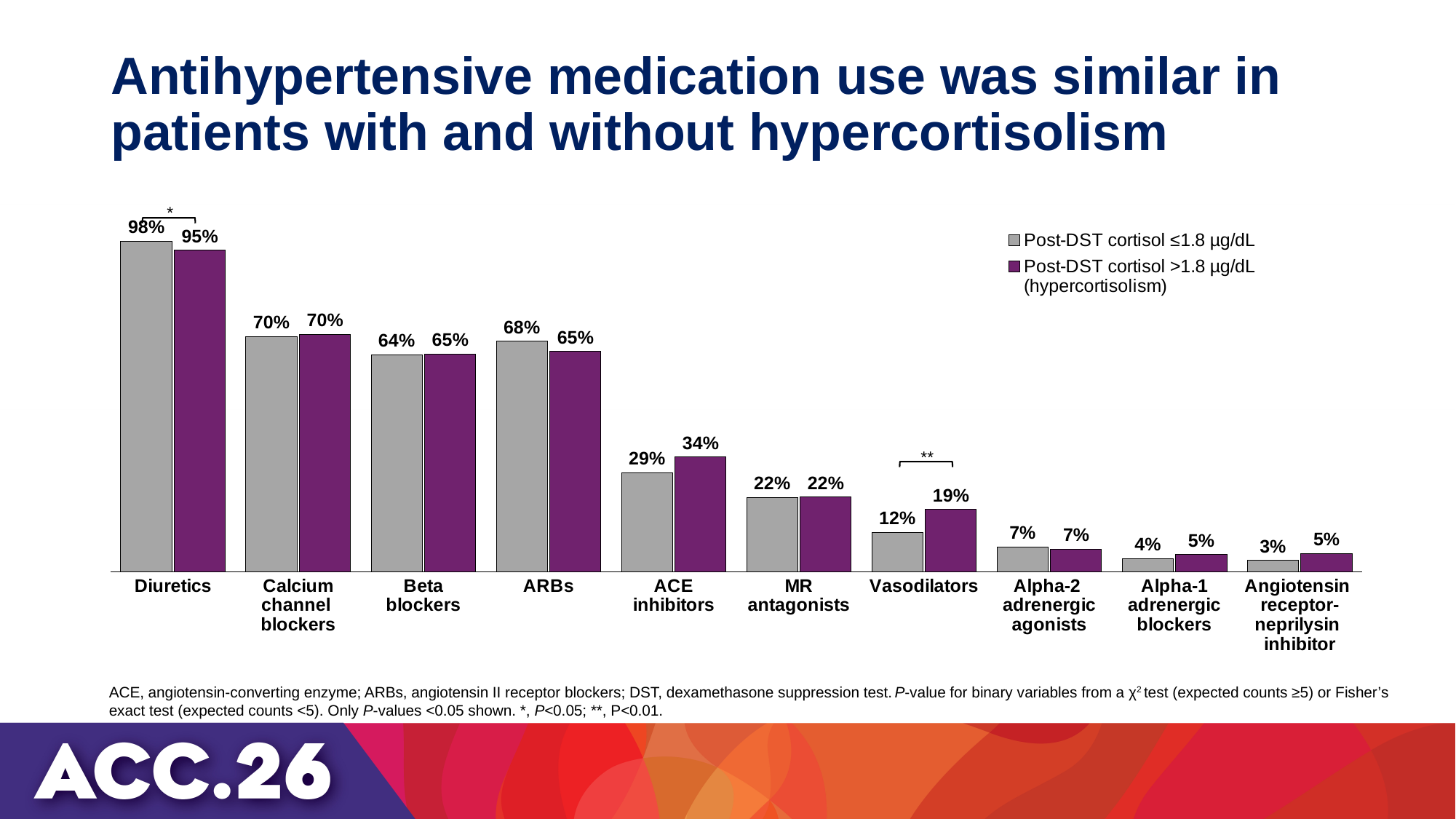
What is the difference between the two series for Diuretics? 3% Which medication category has the highest value in the Post-DST cortisol >1.8 µg/dL (hypercortisolism) series? Diuretics What is the difference between the two series for Vasodilators? 7% What is the value for Diuretics in the Post-DST cortisol ≤1.8 µg/dL series? 98% Which colour represents the Post-DST cortisol >1.8 µg/dL (hypercortisolism) series? Purple What kind of chart is shown on the slide? Bar chart What is the value for ACE inhibitors in the Post-DST cortisol >1.8 µg/dL (hypercortisolism) series? 34% How many medication categories are shown on the x axis? 10 For ACE inhibitors, which series has the larger value? Post-DST cortisol >1.8 µg/dL (hypercortisolism) What is the value for Vasodilators in the Post-DST cortisol ≤1.8 µg/dL series? 12% How many series does the legend list? 2 Which medication category has the lowest value in the Post-DST cortisol ≤1.8 µg/dL series? Angiotensin receptor-neprilysin inhibitor